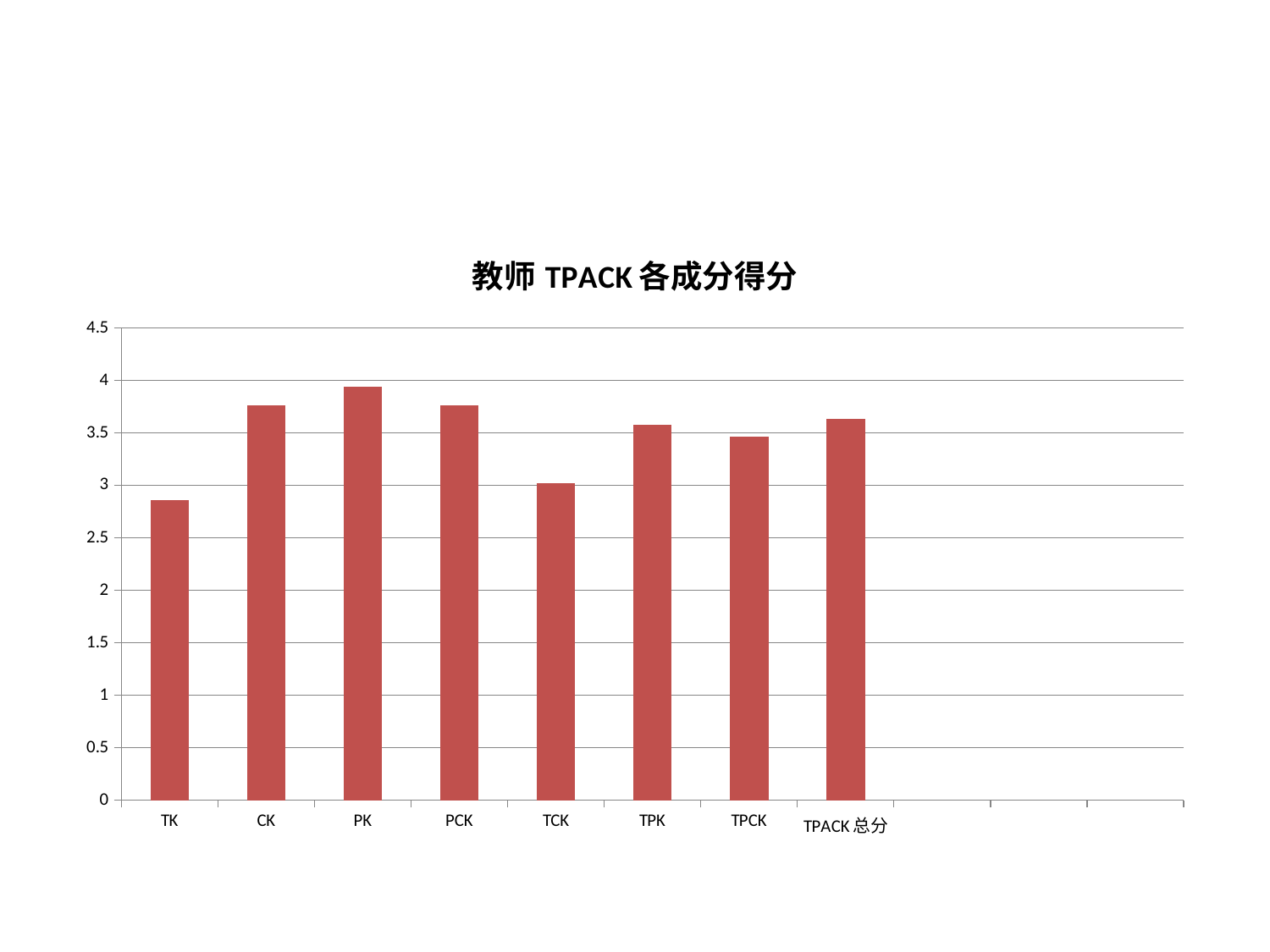
Which is larger, the value for TCK or the value for TPK? TPK What is the title of the chart? 教师 TPACK 各成分得分 Is the value for TPACK 总分 greater or less than 3.5? greater Is the value for TK greater or less than 3? less Which category has the lowest score? TK What kind of chart is shown on the slide? bar chart Which category has the highest score? PK How many categories are plotted on the x axis? 8 What is the maximum value shown on the y axis? 4.5 Is the value for PK greater or less than 4? less Which is larger, the value for PK or the value for TK? PK